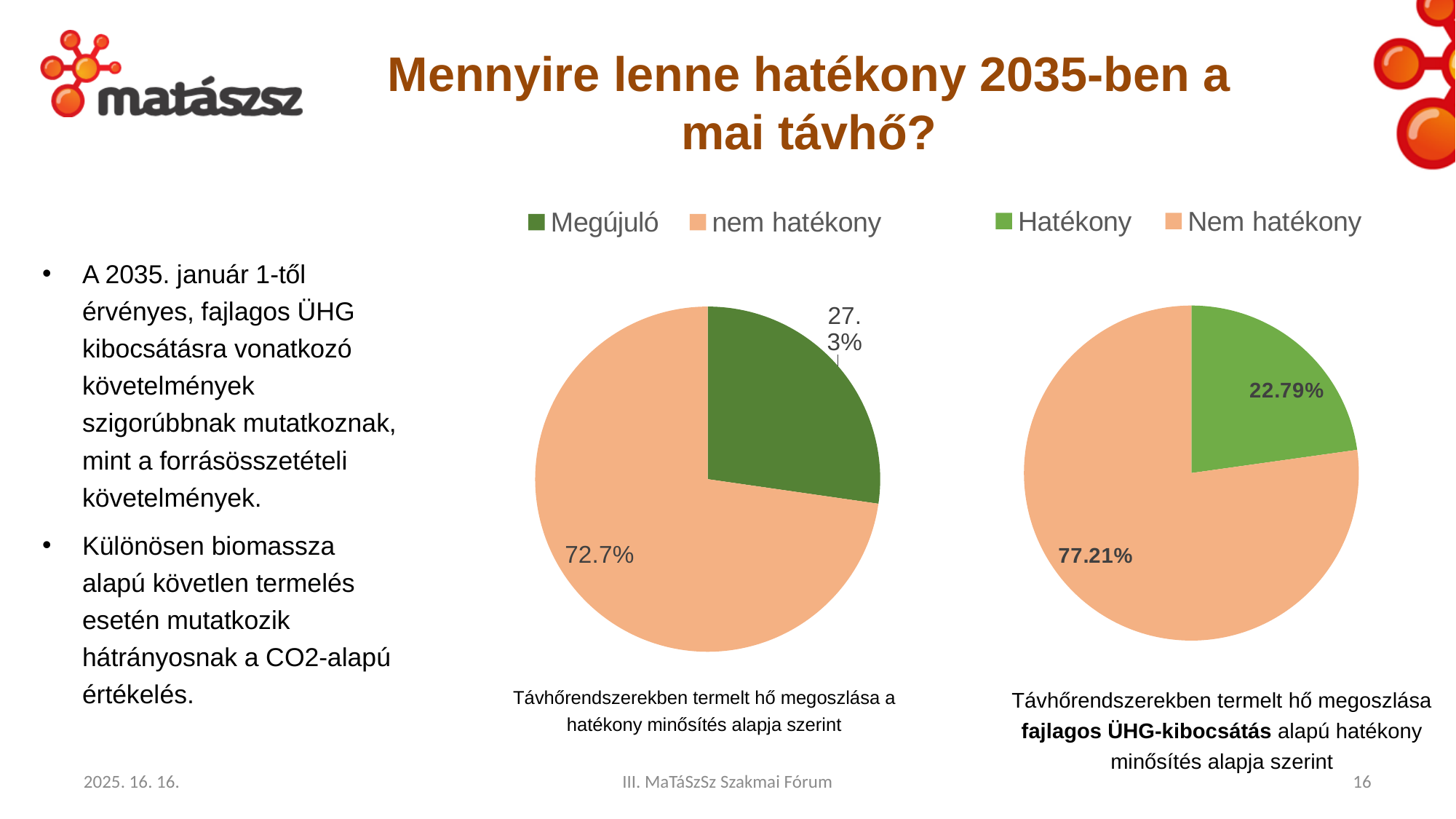
In the right pie chart, what share is labelled for the 'Nem hatékony' slice? 77.21% In the left pie chart, what share is labelled for the 'Megújuló' slice? 27.3% In the right pie chart, which slice is the smallest? Hatékony In the left pie chart, which slice is the largest? nem hatékony What type of chart is the left chart on the slide? Pie chart In the right pie chart, what share is labelled for the 'Hatékony' slice? 22.79% How many entries does the legend of the left pie chart list? 2 In the right pie chart, what is the difference between the 'Nem hatékony' and 'Hatékony' shares? 54.42% In the left pie chart, what share is labelled for the 'nem hatékony' slice? 72.7% Which is larger: the 'Megújuló' share in the left pie chart or the 'Hatékony' share in the right pie chart? Megújuló (left pie chart) How many slices does the right pie chart have? 2 In the left pie chart, what is the difference between the 'nem hatékony' and 'Megújuló' shares? 45.4%